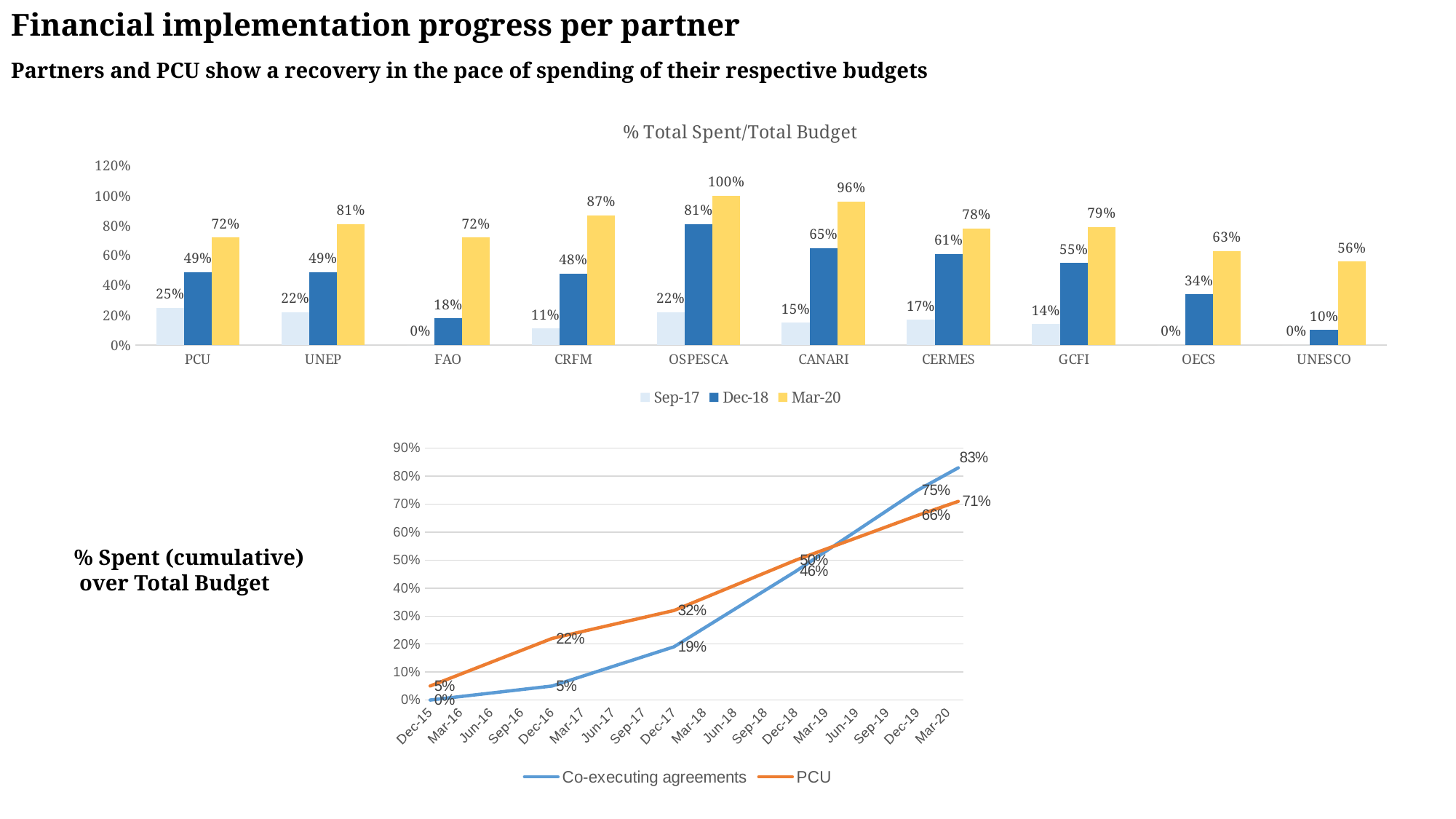
In the '% Spent (cumulative) over Total Budget' line chart, what is the value for Co-executing agreements at Mar-20? 83% How many series does the legend of the '% Total Spent/Total Budget' bar chart list? 3 In the '% Spent (cumulative) over Total Budget' line chart, does the Co-executing agreements line rise or fall from Dec-15 to Mar-20? Rise In the '% Total Spent/Total Budget' bar chart, which partner has the highest Dec-18 value? OSPESCA In the '% Spent (cumulative) over Total Budget' line chart, what is the value for PCU at Dec-17? 32% What type of chart is the '% Spent (cumulative) over Total Budget' chart at the bottom of the slide? Line chart How many partners are shown on the x axis of the '% Total Spent/Total Budget' bar chart? 10 In the '% Total Spent/Total Budget' bar chart, what is the difference between the Mar-20 and Dec-18 values for FAO? 54% In the '% Total Spent/Total Budget' bar chart, which partner has the lowest Mar-20 value? UNESCO In the '% Total Spent/Total Budget' bar chart, what is the Mar-20 value for OSPESCA? 100% In the '% Total Spent/Total Budget' bar chart, which is larger: the Mar-20 value for CRFM or the Mar-20 value for GCFI? CRFM In the '% Total Spent/Total Budget' bar chart, what is the Dec-18 value for CANARI? 65%